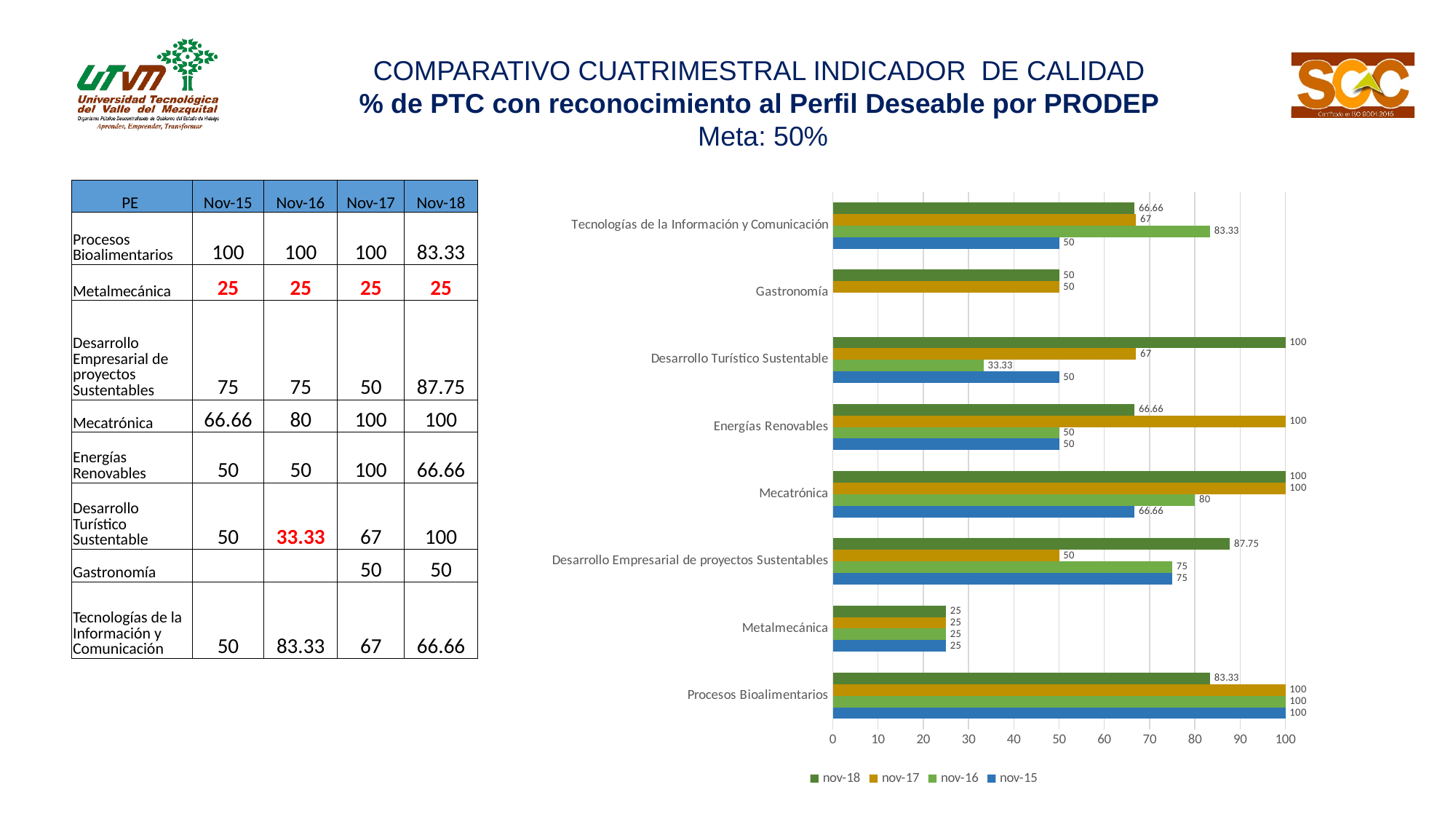
What is the nov-18 value for Desarrollo Empresarial de proyectos Sustentables? 87.75 Which is larger: the nov-16 value for Tecnologías de la Información y Comunicación or the nov-16 value for Mecatrónica? Tecnologías de la Información y Comunicación How much higher is the nov-17 value than the nov-18 value for Procesos Bioalimentarios? 16.67 Which category has the lowest nov-18 value? Metalmecánica How much higher is the nov-17 value than the nov-16 value for Desarrollo Turístico Sustentable? 33.67 What kind of chart is shown on the slide? Bar chart What is the nov-16 value for Desarrollo Turístico Sustentable? 33.33 How many categories are shown on the chart? 8 Which colour represents the nov-15 series in the legend? Blue How many series does the legend list? 4 Which category has the highest nov-16 value? Procesos Bioalimentarios What is the nov-15 value for Mecatrónica? 66.66